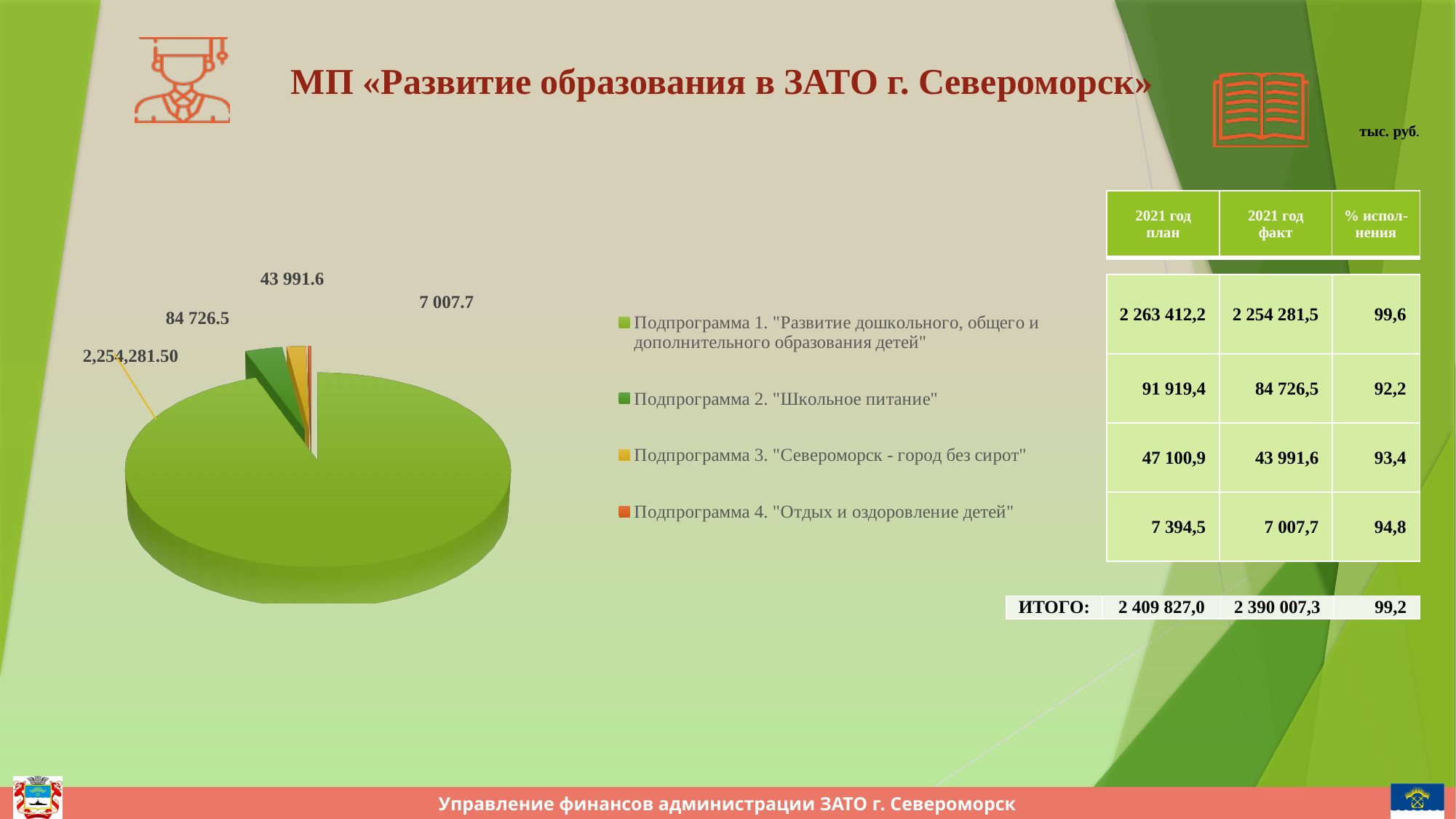
How many slices does the pie chart have? 4 How many entries does the pie chart's legend list? 4 In the pie chart, which is larger: the value for Подпрограмма 2 or the value for Подпрограмма 3? Подпрограмма 2 What colour is the slice for Подпрограмма 4. "Отдых и оздоровление детей" in the pie chart? orange-red What is the difference between the pie chart values for Подпрограмма 2 (84 726.5) and Подпрограмма 3 (43 991.6)? 40 734.9 What value is labelled on the pie chart for Подпрограмма 1. "Развитие дошкольного, общего и дополнительного образования детей"? 2,254,281.50 What value is labelled on the pie chart for Подпрограмма 4. "Отдых и оздоровление детей"? 7 007.7 What value is labelled on the pie chart for Подпрограмма 2. "Школьное питание"? 84 726.5 What value is labelled on the pie chart for Подпрограмма 3. "Североморск - город без сирот"? 43 991.6 Which subprogram has the smallest slice in the pie chart? Подпрограмма 4. "Отдых и оздоровление детей" Which subprogram has the largest slice in the pie chart? Подпрограмма 1. "Развитие дошкольного, общего и дополнительного образования детей" What type of chart is shown on the slide? pie chart